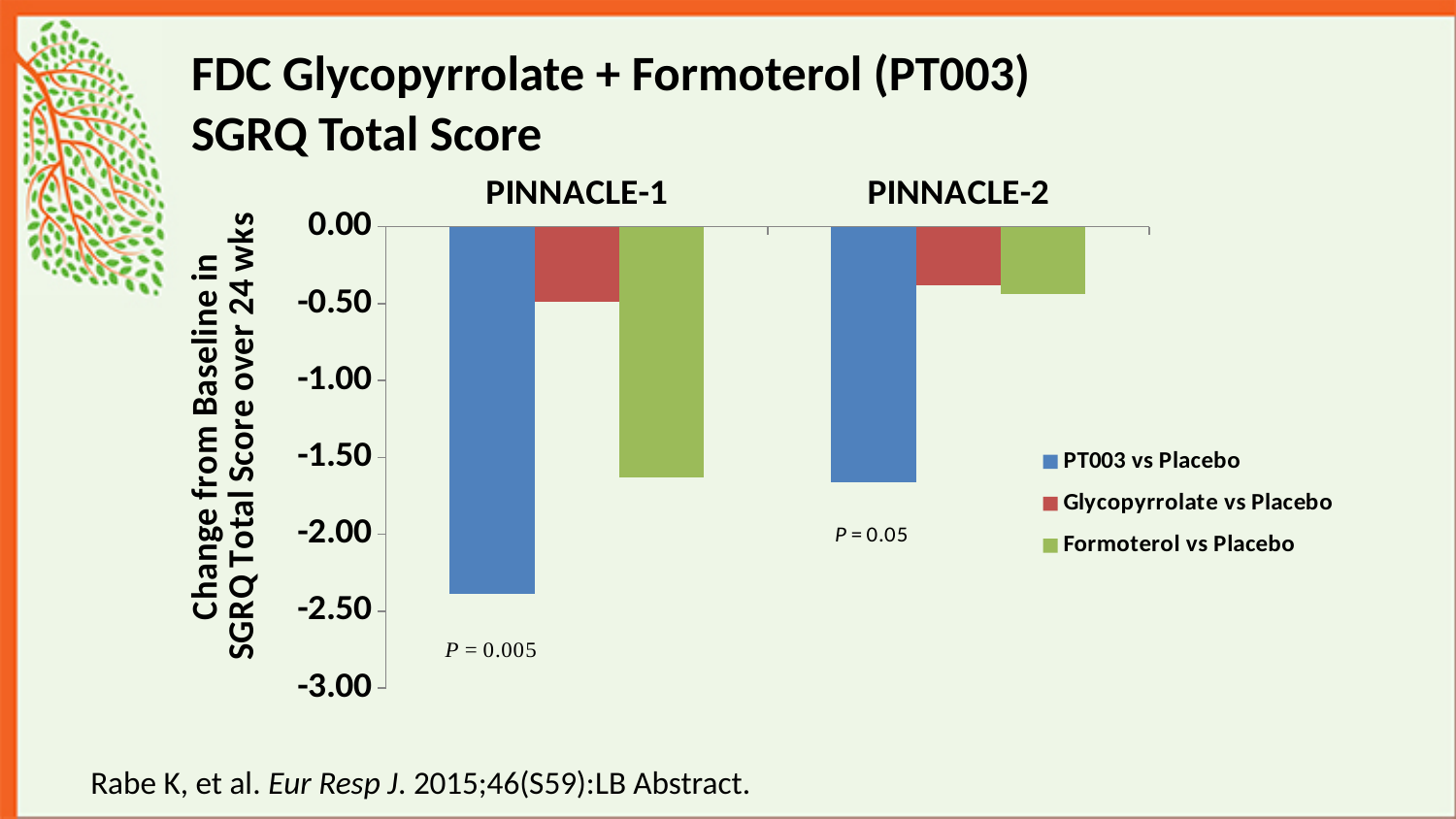
Is the value for PT003 vs Placebo in PINNACLE-1 greater or less than -2.00? less In which study is the reduction in SGRQ total score for PT003 vs Placebo larger, PINNACLE-1 or PINNACLE-2? PINNACLE-1 Is the value for Formoterol vs Placebo in PINNACLE-1 greater or less than -1.50? less How many series does the legend list? 3 What P value is shown for PINNACLE-1? P = 0.005 How many study categories are shown on the x axis? 2 Is the value for Glycopyrrolate vs Placebo in PINNACLE-2 greater or less than -0.50? greater Which comparison shows the smallest change in SGRQ total score in PINNACLE-1? Glycopyrrolate vs Placebo What kind of chart is shown on the slide? bar chart Which comparison shows the largest reduction in SGRQ total score in PINNACLE-2? PT003 vs Placebo Which comparison shows the largest reduction in SGRQ total score in PINNACLE-1? PT003 vs Placebo